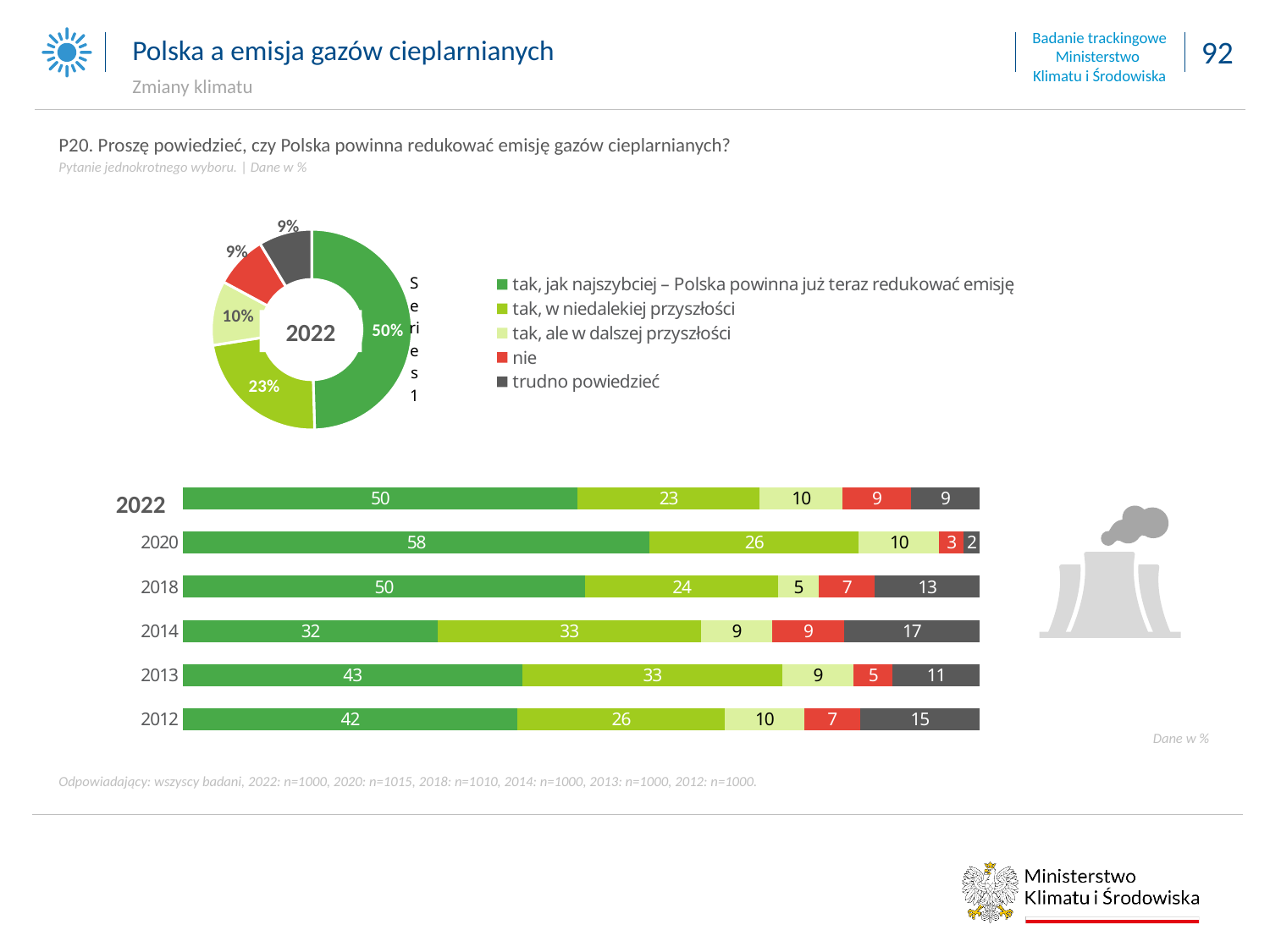
In the lower bar chart, what is the total of the 2012 bar? 100 In the lower bar chart, which year has the lowest value for 'tak, jak najszybciej'? 2014 In the lower bar chart, what is the value for 'trudno powiedzieć' in 2014? 17 In the lower bar chart, which year has the highest value for 'tak, jak najszybciej'? 2020 In the lower bar chart, what is the value for 'tak, jak najszybciej' in 2020? 58 How many entries does the legend of the doughnut chart list? 5 In the doughnut chart, what share is shown for 'tak, jak najszybciej – Polska powinna już teraz redukować emisję'? 50% In the doughnut chart, what share is shown for 'tak, w niedalekiej przyszłości'? 23% In the lower bar chart, what is the difference between the 'tak, jak najszybciej' values for 2020 and 2014? 26 How many years are shown in the lower bar chart? 6 What year is shown in the centre of the doughnut chart? 2022 What kind of chart is the lower chart showing the years 2012 to 2022? Stacked bar chart